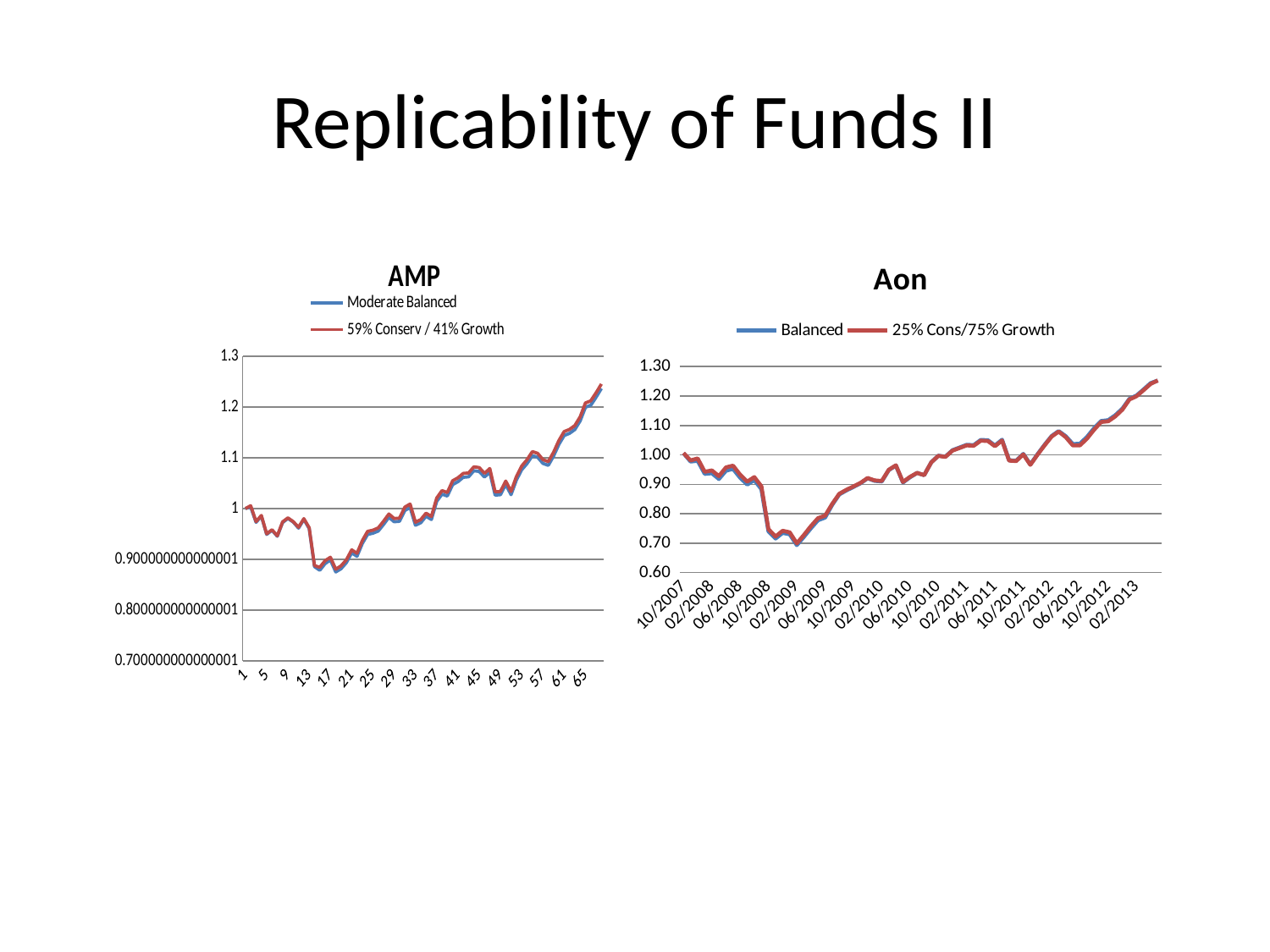
In the AMP chart, is the value of the Moderate Balanced series at point 65 greater or less than 1.1? greater How many series does the legend of the Aon chart list? 2 In the Aon chart, do the values of the 25% Cons/75% Growth series rise or fall between 06/2012 and 02/2013? rise In the AMP chart, is the lowest value of the 59% Conserv / 41% Growth series greater or less than 0.9? less What kind of chart is the Aon chart? line chart How many series does the legend of the AMP chart list? 2 In the AMP chart, what is the name of the series drawn in blue? Moderate Balanced What kind of chart is the AMP chart? line chart In the Aon chart, what is the name of the series drawn in red? 25% Cons/75% Growth In the Aon chart, do the values of the Balanced series rise or fall between 10/2007 and 02/2009? fall In the Aon chart, is the value of the Balanced series at 02/2009 greater or less than 0.80? less